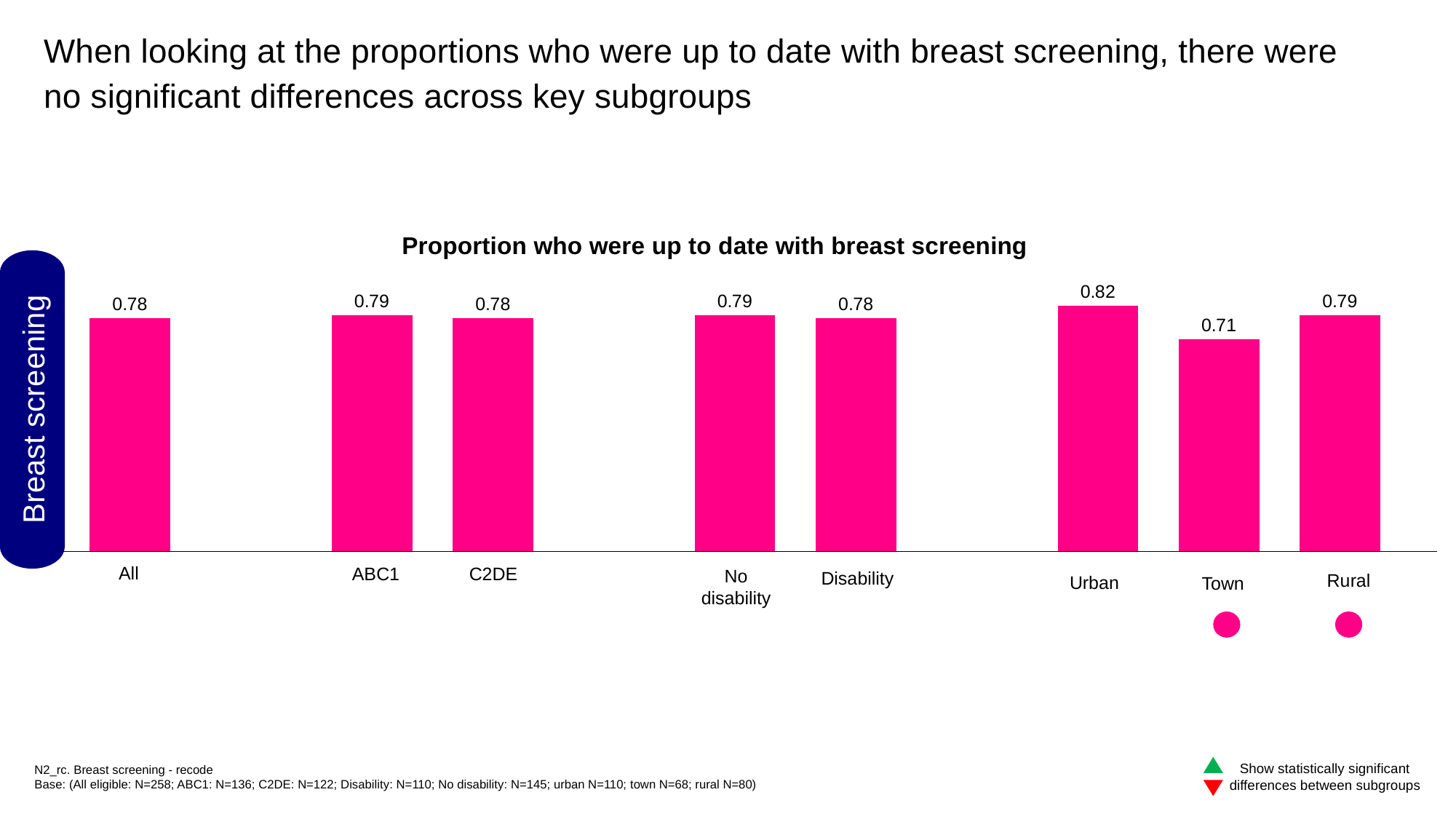
Which category has the highest value? Urban What kind of chart is shown on the slide? Bar chart How many categories are shown in the chart? 8 What is the value for All? 0.78 Which is larger, the value for Rural or the value for Town? Rural What is the title of the chart? Proportion who were up to date with breast screening Which category has the lowest value? Town What is the value for Urban? 0.82 What is the value for ABC1? 0.79 What is the difference between the values for Urban and Town? 0.11 What is the difference between the values for No disability and Disability? 0.01 What is the value for Town? 0.71